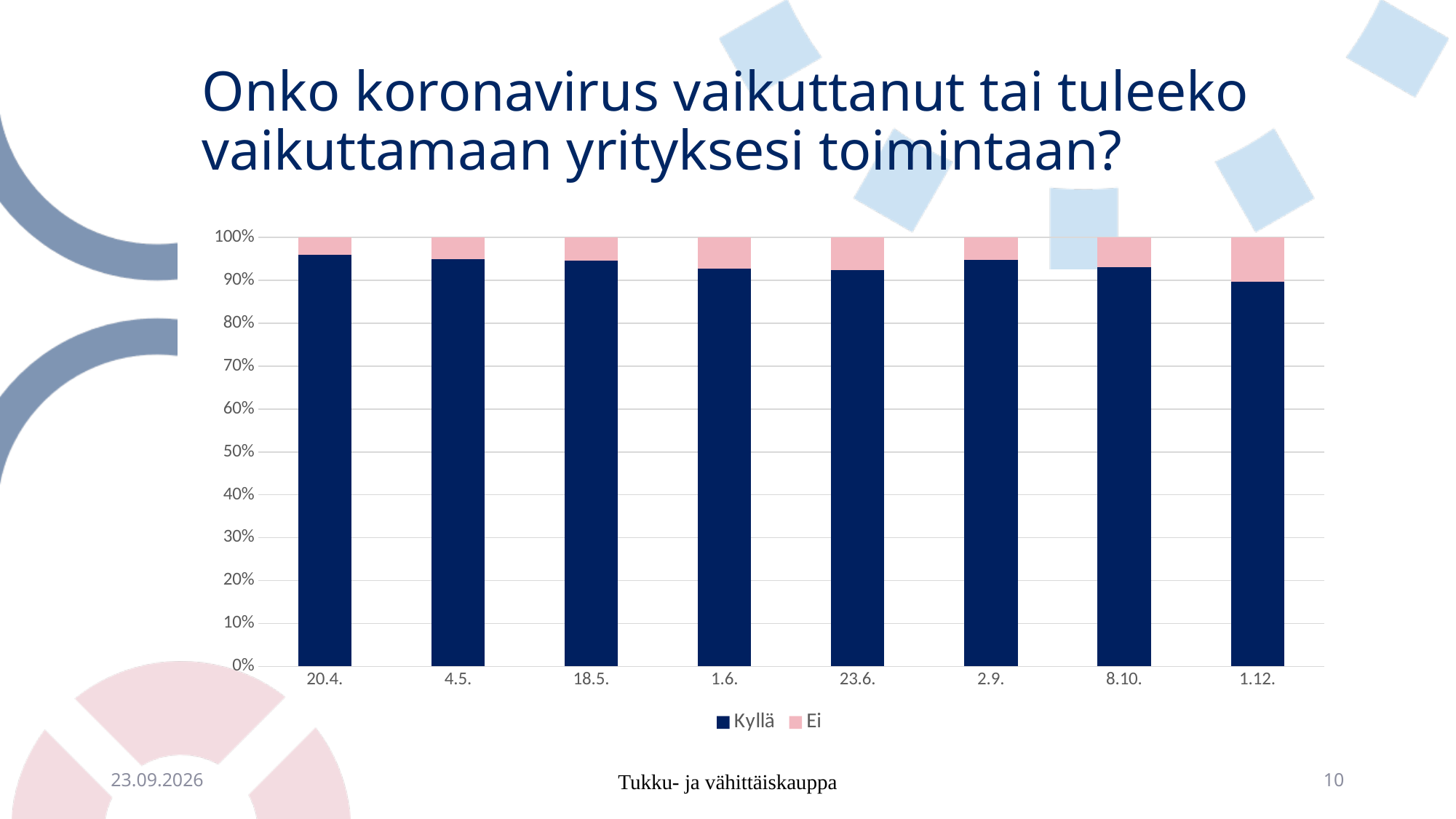
On which date is the Ei share highest? 1.12. On which date is the Kyllä share lowest? 1.12. How many series does the legend list? 2 Is the Kyllä value for 1.12. greater or less than 95%? less What are the two series named in the legend? Kyllä and Ei Is the Kyllä value for 20.4. greater or less than 90%? greater What is the total height of each stacked bar? 100% Which is larger, the Kyllä share for 20.4. or for 1.12.? 20.4. Is the Kyllä value for 1.6. greater or less than 90%? greater Which colour represents the Kyllä series? dark blue What kind of chart is shown on the slide? stacked bar chart How many dates (categories) are shown on the x axis? 8